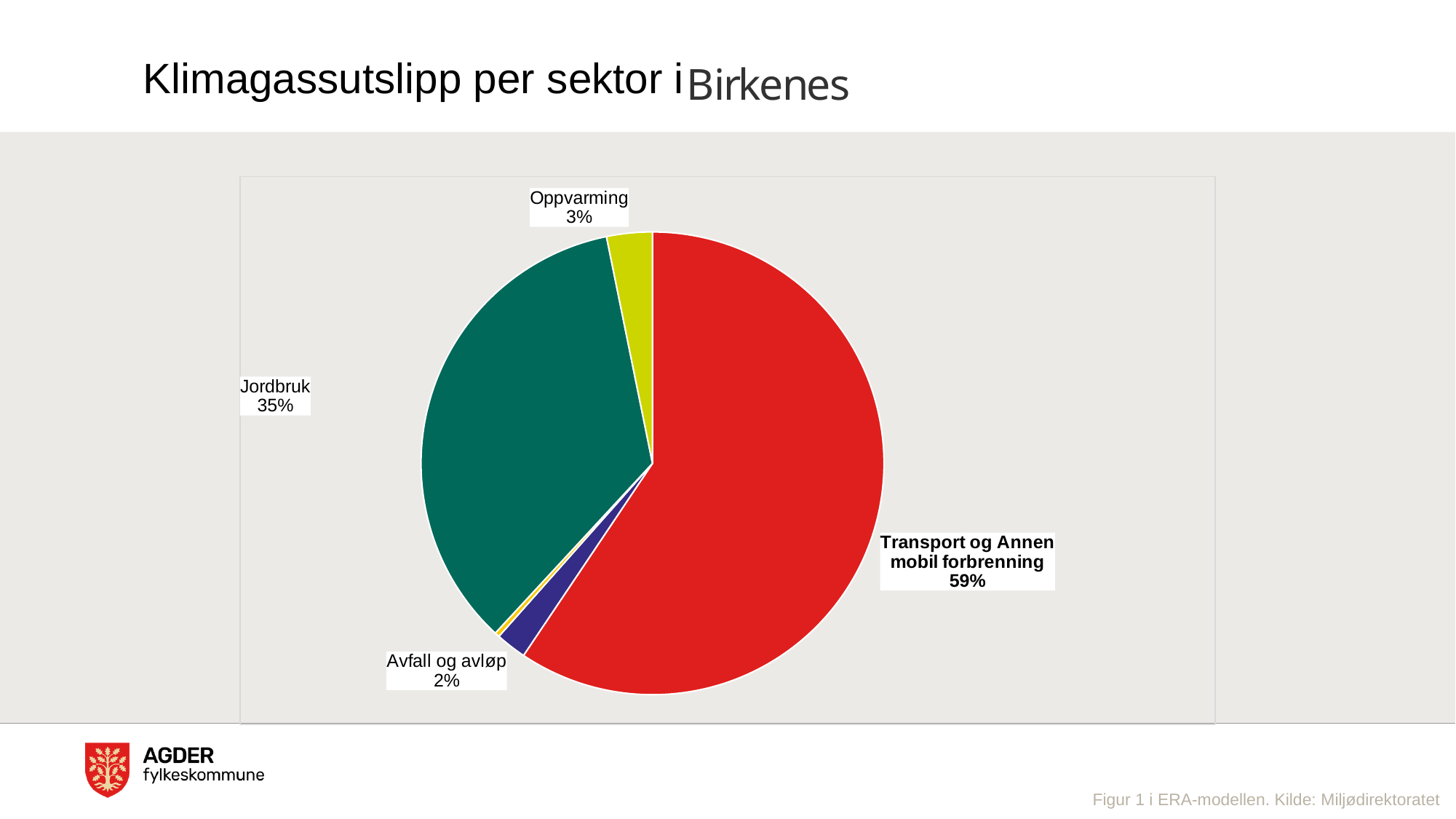
What colour is the Jordbruk slice of the pie? green Which is larger, the share for Jordbruk or the share for Transport og Annen mobil forbrenning? Transport og Annen mobil forbrenning Which is larger, the share for Oppvarming or the share for Avfall og avløp? Oppvarming What is the difference in percentage points between Transport og Annen mobil forbrenning and Jordbruk? 24 percentage points What is the title of the slide? Klimagassutslipp per sektor i Birkenes What is the value shown for Jordbruk? 35% What share of the pie does Transport og Annen mobil forbrenning account for? 59% What kind of chart is shown on the slide? pie chart Which sector has the largest share of the pie? Transport og Annen mobil forbrenning Which of the labelled sectors has the smallest share of the pie? Avfall og avløp What is the value shown for Oppvarming? 3% What is the value shown for Avfall og avløp? 2%